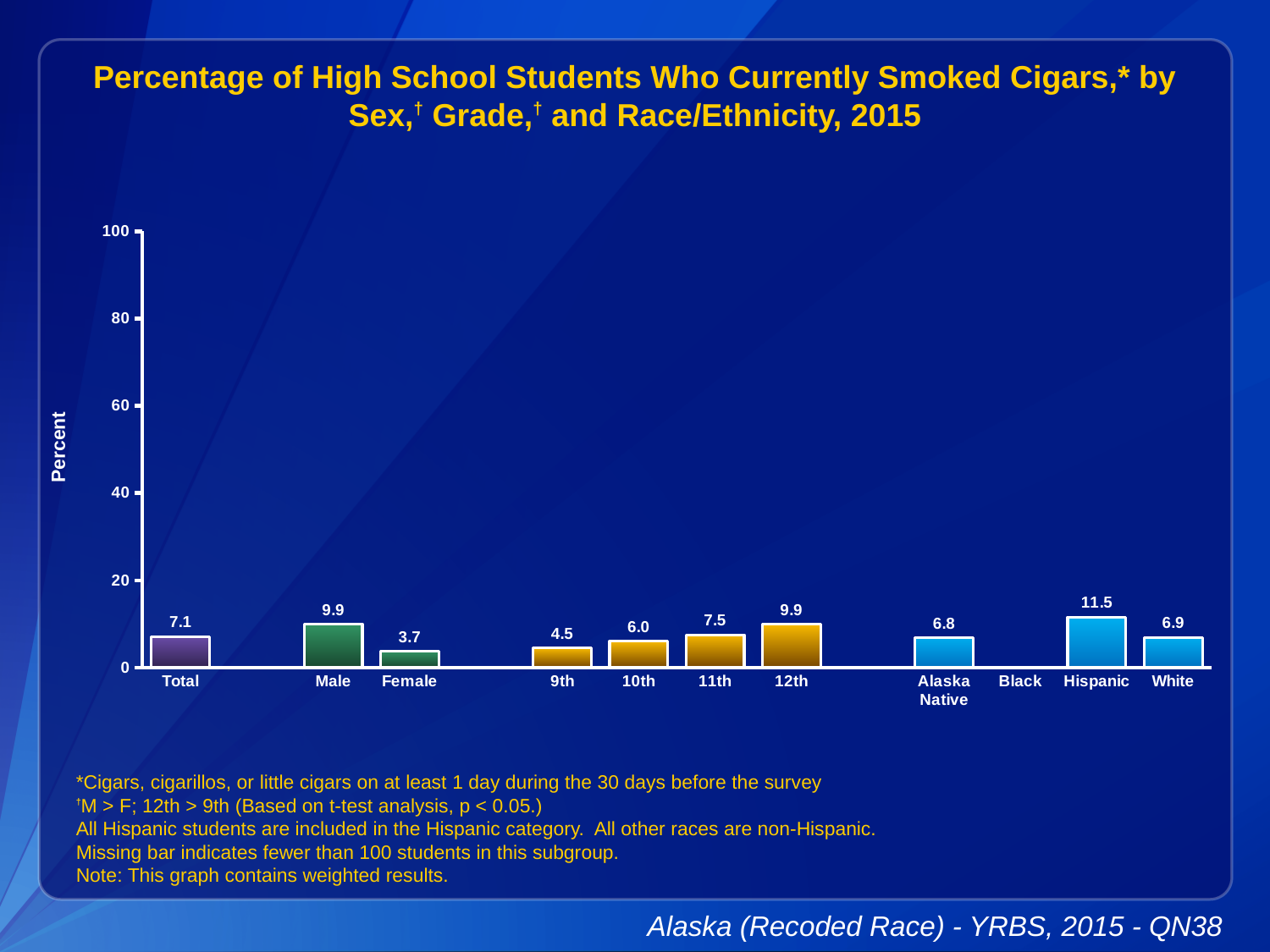
Do the values rise or fall from 9th grade to 12th grade? rise Which category has the highest value? Hispanic What kind of chart is shown? bar chart Which category with a bar has the lowest value? Female What is the difference between the Male and Female values? 6.2 What is the value for Female? 3.7 What is the value for Hispanic? 11.5 What is the value for 10th grade? 6.0 What is the value for Total? 7.1 Which is larger, the value for 11th grade or the value for 12th grade? 12th Is the value for Hispanic greater or less than 20? less Which category has no bar shown? Black